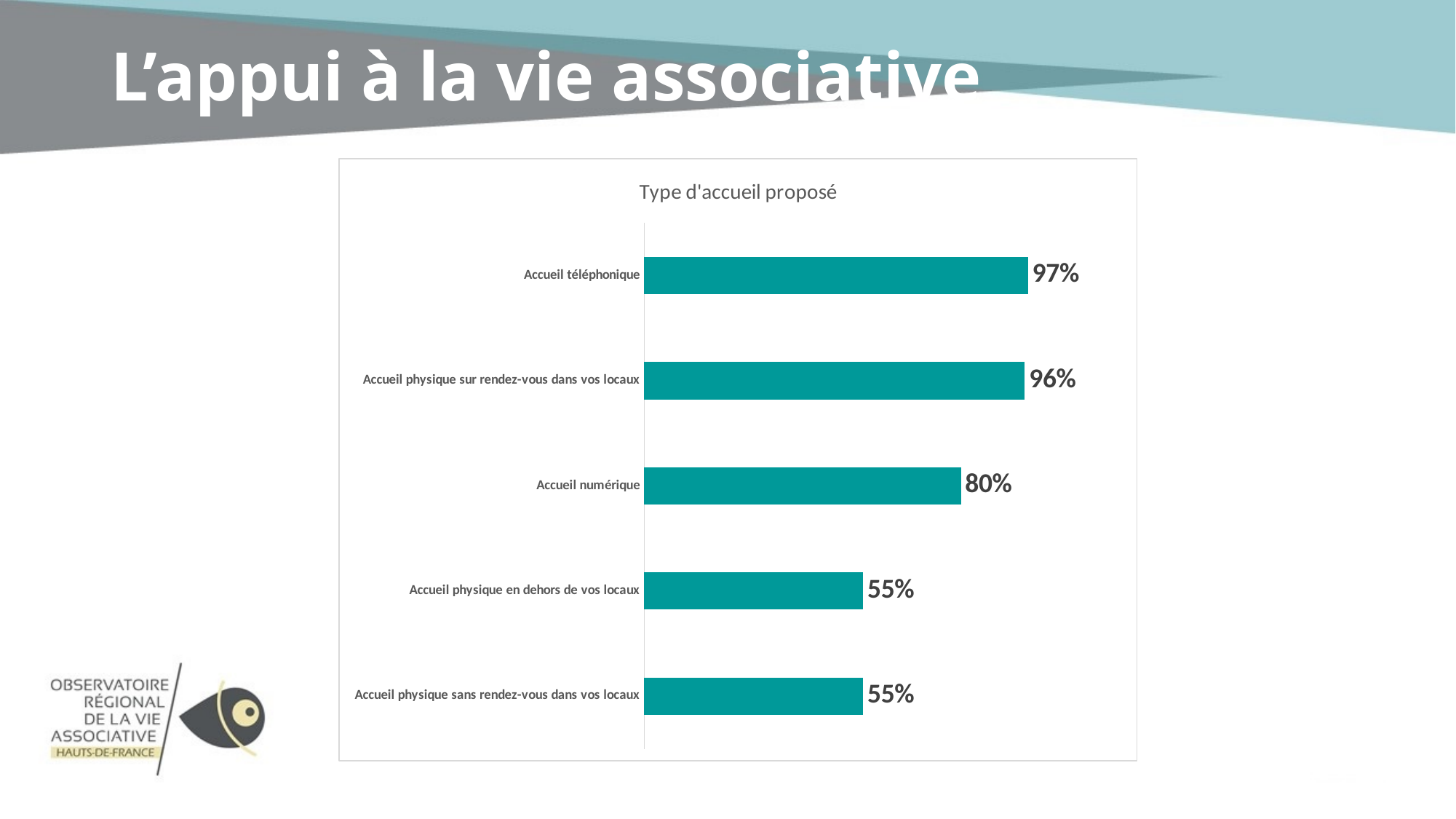
What colour are the bars in the chart? Teal What is the value for Accueil téléphonique? 97% What is the difference between Accueil physique sur rendez-vous dans vos locaux and Accueil physique sans rendez-vous dans vos locaux? 41% What is the value for Accueil physique sur rendez-vous dans vos locaux? 96% What is the value for Accueil numérique? 80% What kind of chart is shown on the slide? Bar chart What is the title of the chart? Type d'accueil proposé Which is larger, Accueil numérique or Accueil physique en dehors de vos locaux? Accueil numérique What is the value for Accueil physique en dehors de vos locaux? 55% How many categories are shown in the chart? 5 Which category has the highest value? Accueil téléphonique What is the difference between Accueil téléphonique and Accueil numérique? 17%